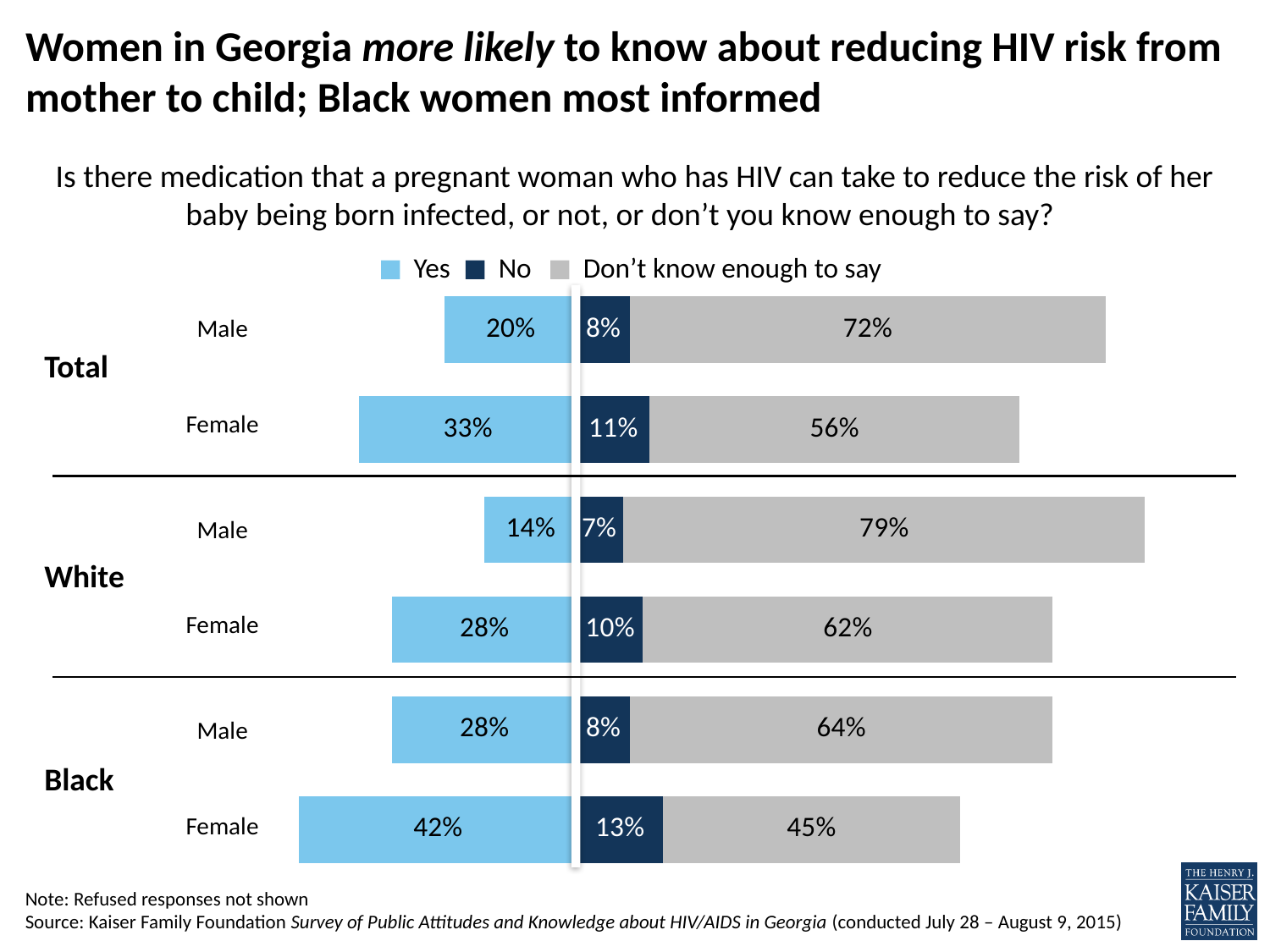
What percentage of Black women answered "Yes"? 42% Which colour represents the "No" response in the chart? Dark navy blue Which group has the highest "Yes" percentage? Black Female Which is larger: the "Don't know enough to say" share for White women or for Black men? Black men (64%) What is the total of the three labeled segments for the Total Male bar? 100% Which group has the lowest "Yes" percentage? White Male What percentage of White men answered "Don't know enough to say"? 79% How many response categories does the legend list? 3 What percentage of women in the Total group answered "No"? 11% What type of chart is shown on the slide? Stacked horizontal bar chart What is the difference between the "Yes" percentages for Black women and Black men? 14 percentage points How many bars are shown in the chart? 6